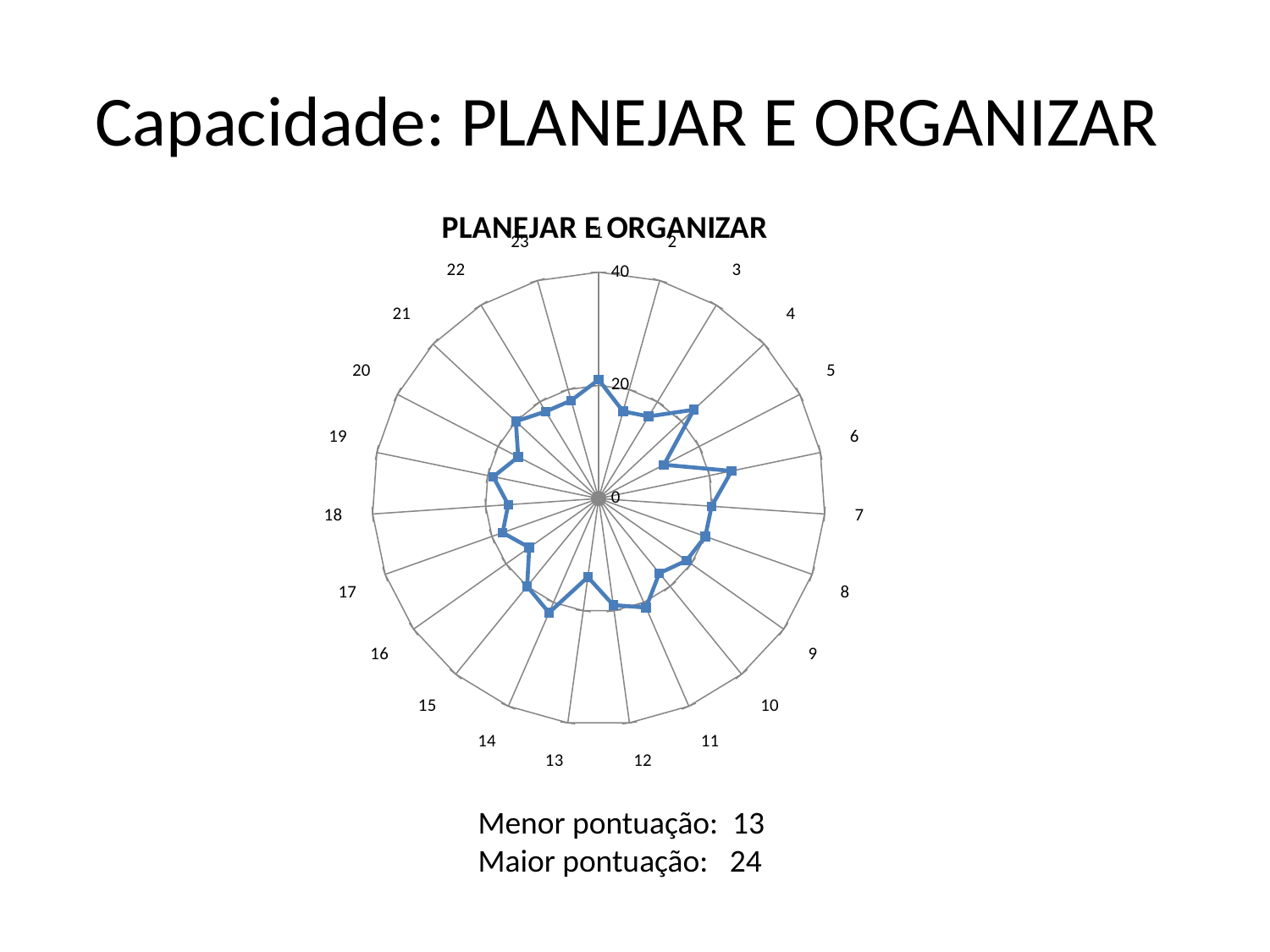
Is the value for category 6 greater or less than 20? greater Is the value for category 2 greater or less than 20? less How many categories are plotted around the radar chart? 23 Is the value for category 6 greater or less than 40? less What kind of chart is shown on the slide? radar chart What is the title of the chart? PLANEJAR E ORGANIZAR According to the text below the chart, what is the highest score (Maior pontuação)? 24 What is the highest value shown on the chart's axis scale? 40 According to the text below the chart, what is the lowest score (Menor pontuação)? 13